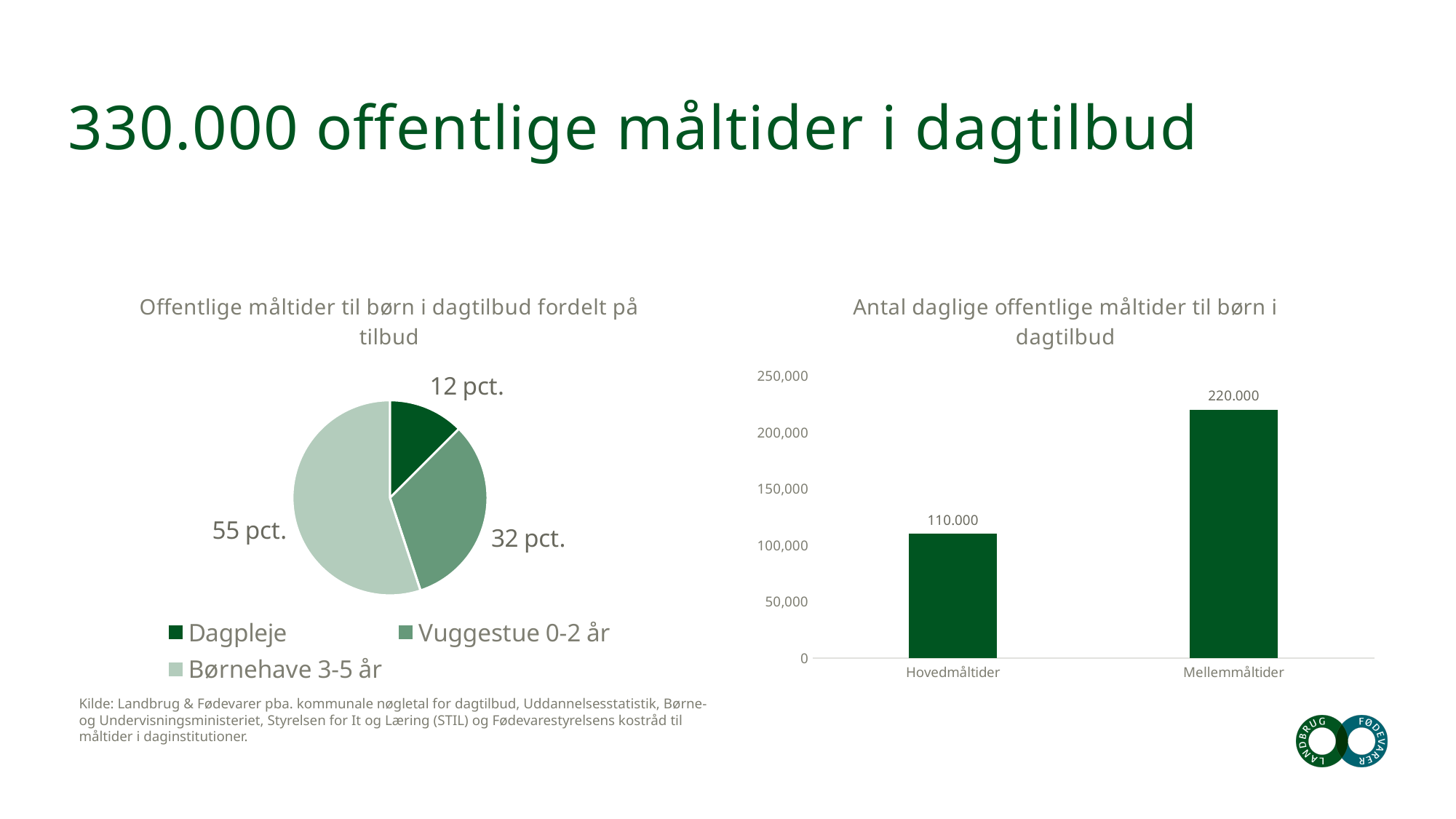
In the pie chart 'Offentlige måltider til børn i dagtilbud fordelt på tilbud', what share is Børnehave 3-5 år? 55 pct. In the pie chart on the left, what is the difference in percentage points between Børnehave 3-5 år and Vuggestue 0-2 år? 23 pct. In the pie chart on the left, which category has the smallest share? Dagpleje What kind of chart is shown on the right side of the slide? Bar chart In the bar chart 'Antal daglige offentlige måltider til børn i dagtilbud', what is the value for Mellemmåltider? 220.000 In the pie chart on the left, which category has the largest share? Børnehave 3-5 år In the bar chart 'Antal daglige offentlige måltider til børn i dagtilbud', what is the value for Hovedmåltider? 110.000 In the bar chart on the right, which category has the higher value, Hovedmåltider or Mellemmåltider? Mellemmåltider In the bar chart on the right, what is the difference between Mellemmåltider and Hovedmåltider? 110.000 In the pie chart 'Offentlige måltider til børn i dagtilbud fordelt på tilbud', what share is Dagpleje? 12 pct. In the pie chart on the left, how many categories does the legend list? 3 In the pie chart 'Offentlige måltider til børn i dagtilbud fordelt på tilbud', what share is Vuggestue 0-2 år? 32 pct.